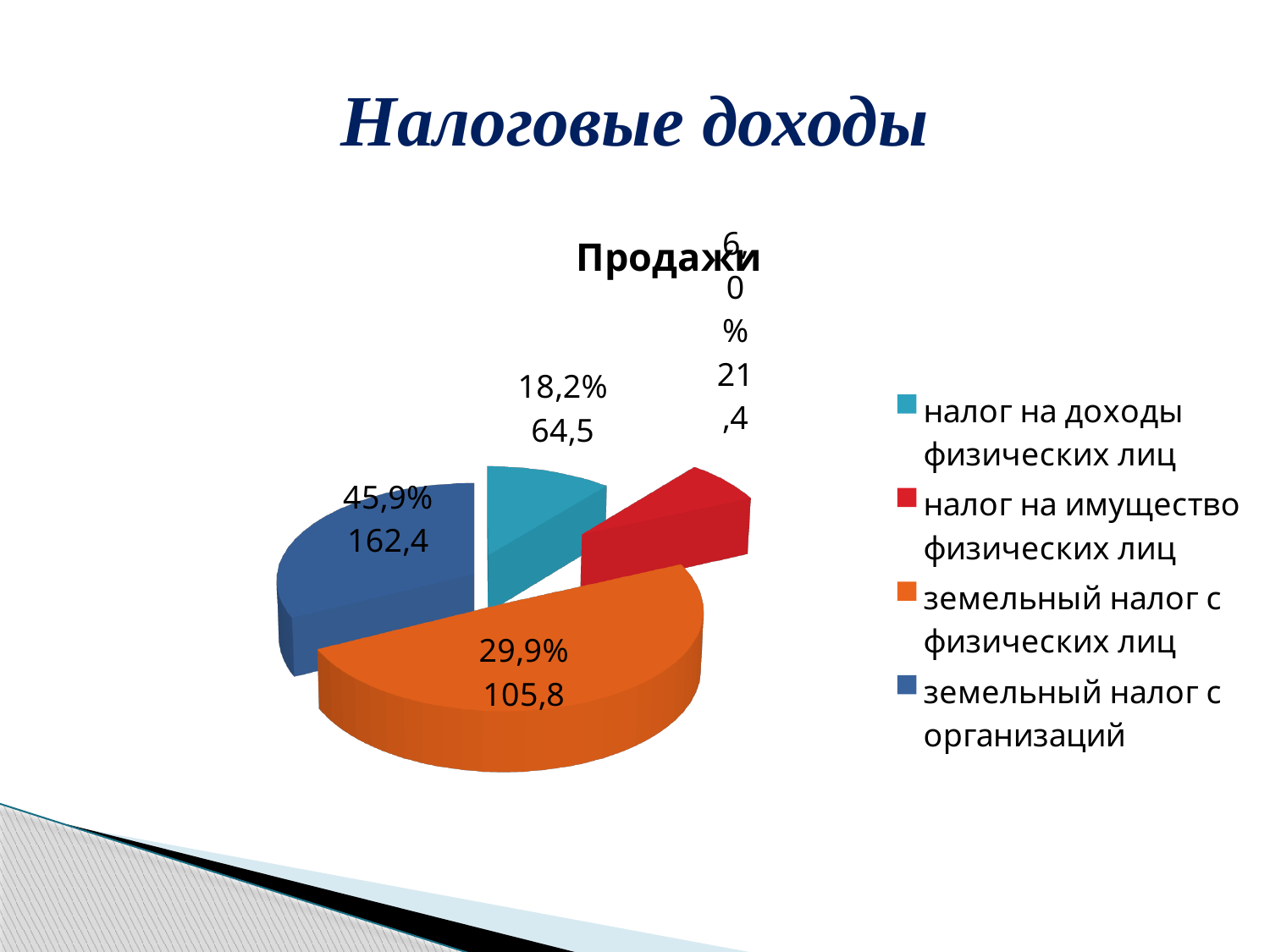
What share of the pie does земельный налог с организаций have? 45,9% Which category has the smallest slice of the pie? налог на имущество физических лиц What value is labelled for земельный налог с физических лиц? 105,8 What is the chart's title? Продажи What is the difference between the values for земельный налог с организаций (162,4) and земельный налог с физических лиц (105,8)? 56,6 What kind of chart is shown on the slide? pie chart What value is labelled for земельный налог с организаций? 162,4 Which is larger: земельный налог с физических лиц or налог на доходы физических лиц? земельный налог с физических лиц What percentage is shown for налог на доходы физических лиц? 18,2% What colour is the slice for налог на имущество физических лиц? red How many slices does the pie chart have? 4